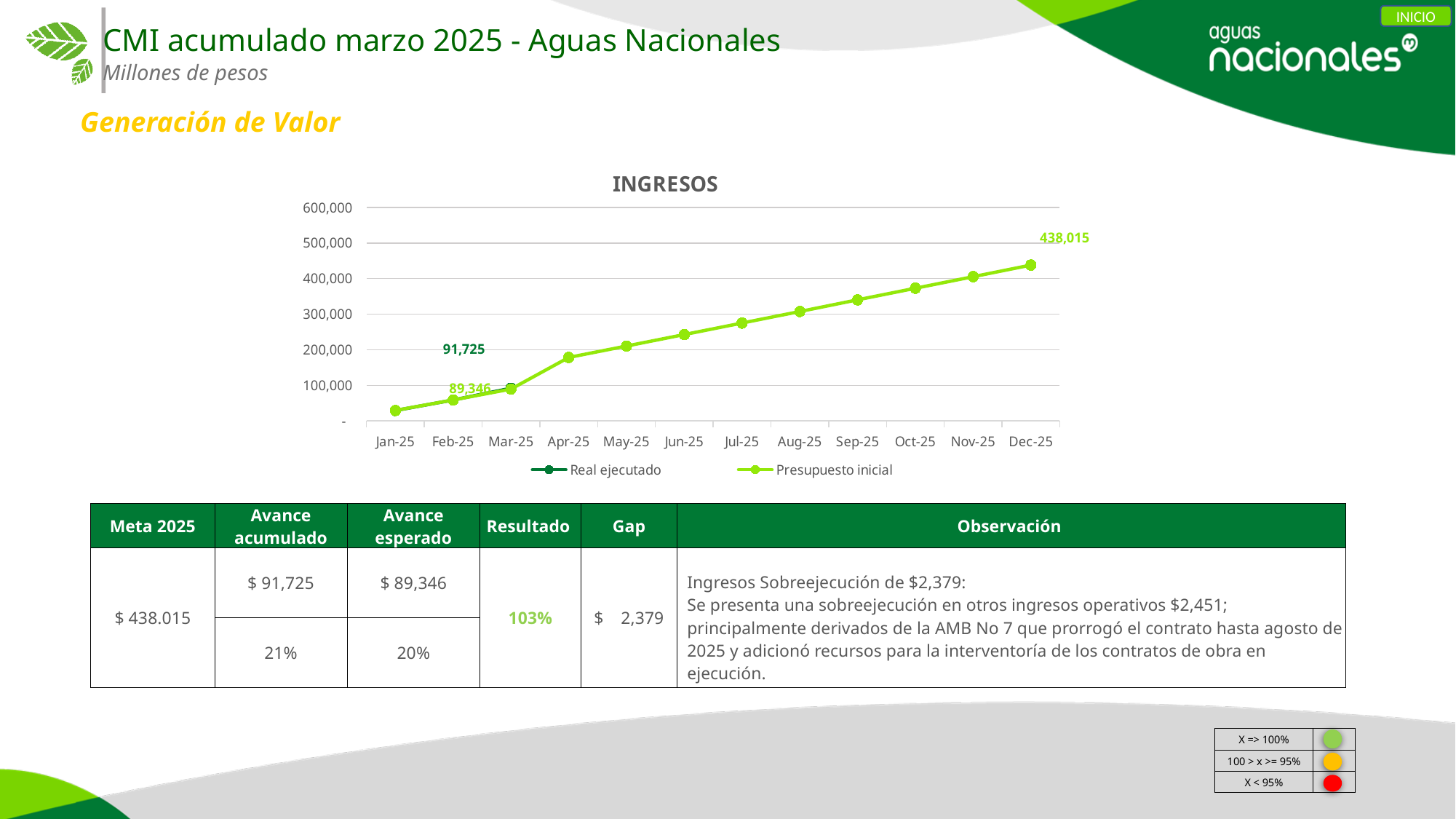
What is the value of Presupuesto inicial for Dec-25 in the INGRESOS chart? 438,015 What is the difference between Real ejecutado and Presupuesto inicial for Mar-25 in the INGRESOS chart? 2,379 Is the Presupuesto inicial value for Jun-25 greater or less than 300,000 in the INGRESOS chart? less What is the value of Real ejecutado for Mar-25 in the INGRESOS chart? 91,725 Is the Presupuesto inicial value for Sep-25 greater or less than 300,000 in the INGRESOS chart? greater How many months are shown on the x axis of the INGRESOS chart? 12 In which month does the Presupuesto inicial series reach its highest value in the INGRESOS chart? Dec-25 For Mar-25, which series has the larger value in the INGRESOS chart, Real ejecutado or Presupuesto inicial? Real ejecutado What is the value of Presupuesto inicial for Mar-25 in the INGRESOS chart? 89,346 How many series does the legend of the INGRESOS chart list? 2 What kind of chart is shown on the slide? line chart Does the Presupuesto inicial series rise or fall from Jan-25 to Dec-25 in the INGRESOS chart? rise